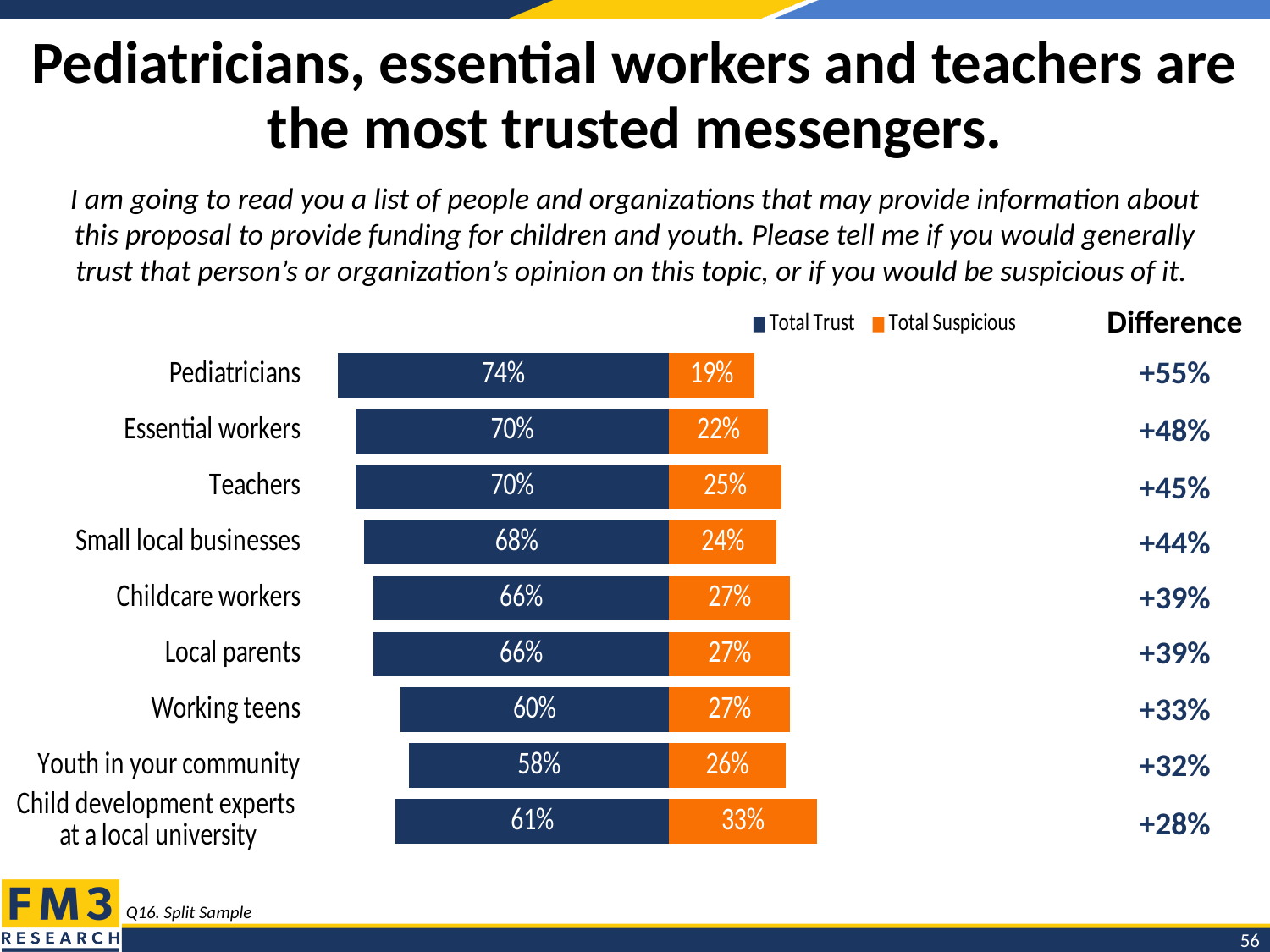
Which category has the lowest Total Suspicious value? Pediatricians Which category has the highest Total Trust value? Pediatricians What is the Difference value shown for Childcare workers? +39% What is the Total Trust value for Working teens? 60% What is the Total Trust value for Pediatricians? 74% How many series does the legend list? 2 Which category has the lowest Total Trust value? Youth in your community Which is larger: the Total Trust value for Essential workers or the Total Trust value for Small local businesses? Essential workers How many categories are shown in the chart? 9 What is the difference between the Total Trust and Total Suspicious values for Teachers? 45% What kind of chart is shown on the slide? Bar chart What is the Total Suspicious value for Child development experts at a local university? 33%